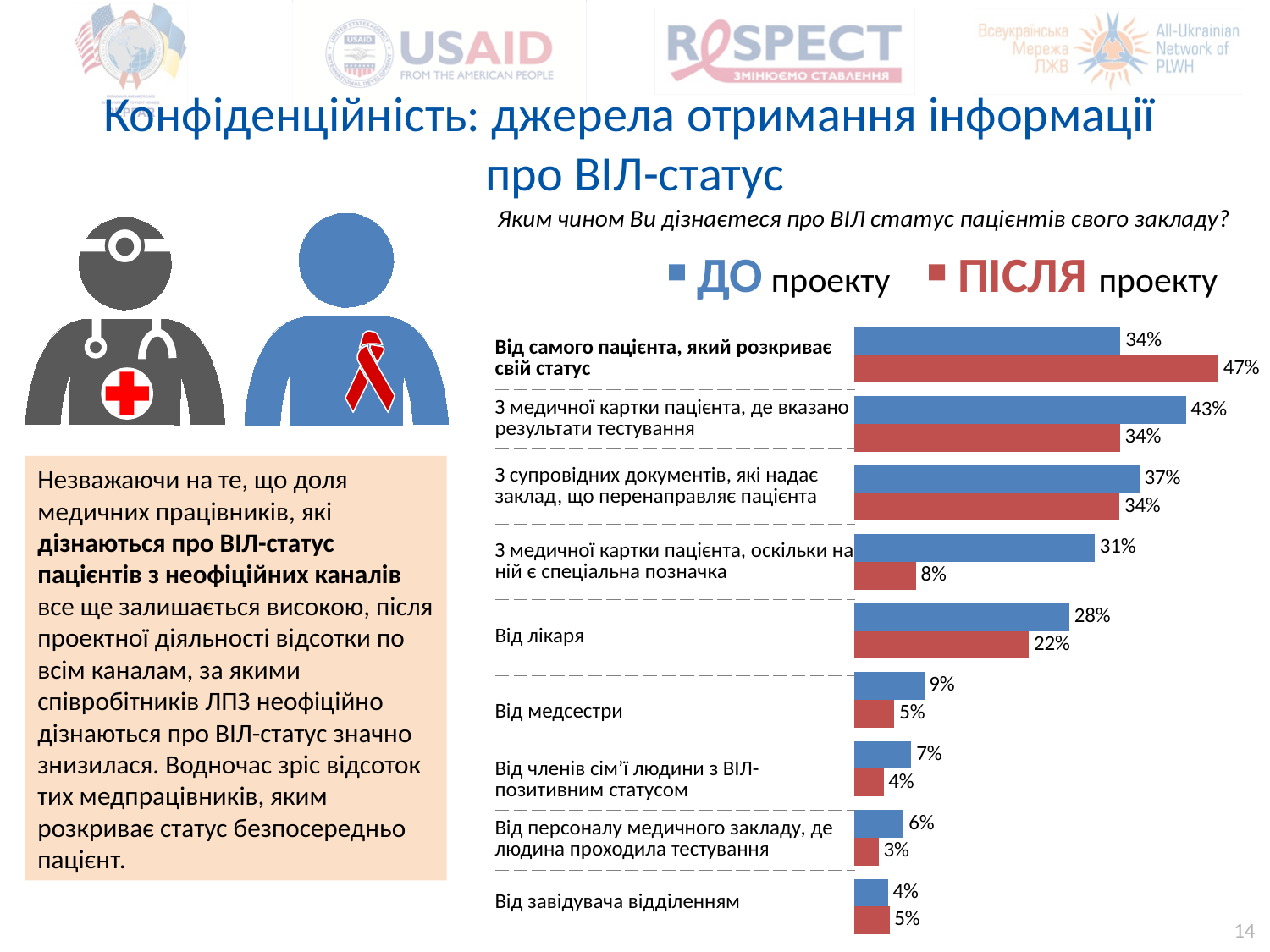
What type of chart is shown on the slide? Bar chart What is the value for "ДО проекту" for "Від самого пацієнта, який розкриває свій статус"? 34% What is the difference between the "ДО проекту" and "ПІСЛЯ проекту" values for "З медичної картки пацієнта, оскільки на ній є спеціальна позначка"? 23% Which category has the lowest value in the "ПІСЛЯ проекту" series? Від персоналу медичного закладу, де людина проходила тестування For "Від завідувача відділенням", which is larger: the "ДО проекту" value or the "ПІСЛЯ проекту" value? ПІСЛЯ проекту Which colour represents the "ПІСЛЯ проекту" series? Red How many categories are shown in the chart? 9 What is the value for "ПІСЛЯ проекту" for "З медичної картки пацієнта, оскільки на ній є спеціальна позначка"? 8% What is the value for "ПІСЛЯ проекту" for "Від самого пацієнта, який розкриває свій статус"? 47% How many series does the legend list? 2 What is the difference between the "ДО проекту" and "ПІСЛЯ проекту" values for "Від лікаря"? 6% Which category has the highest value in the "ДО проекту" series? З медичної картки пацієнта, де вказано результати тестування